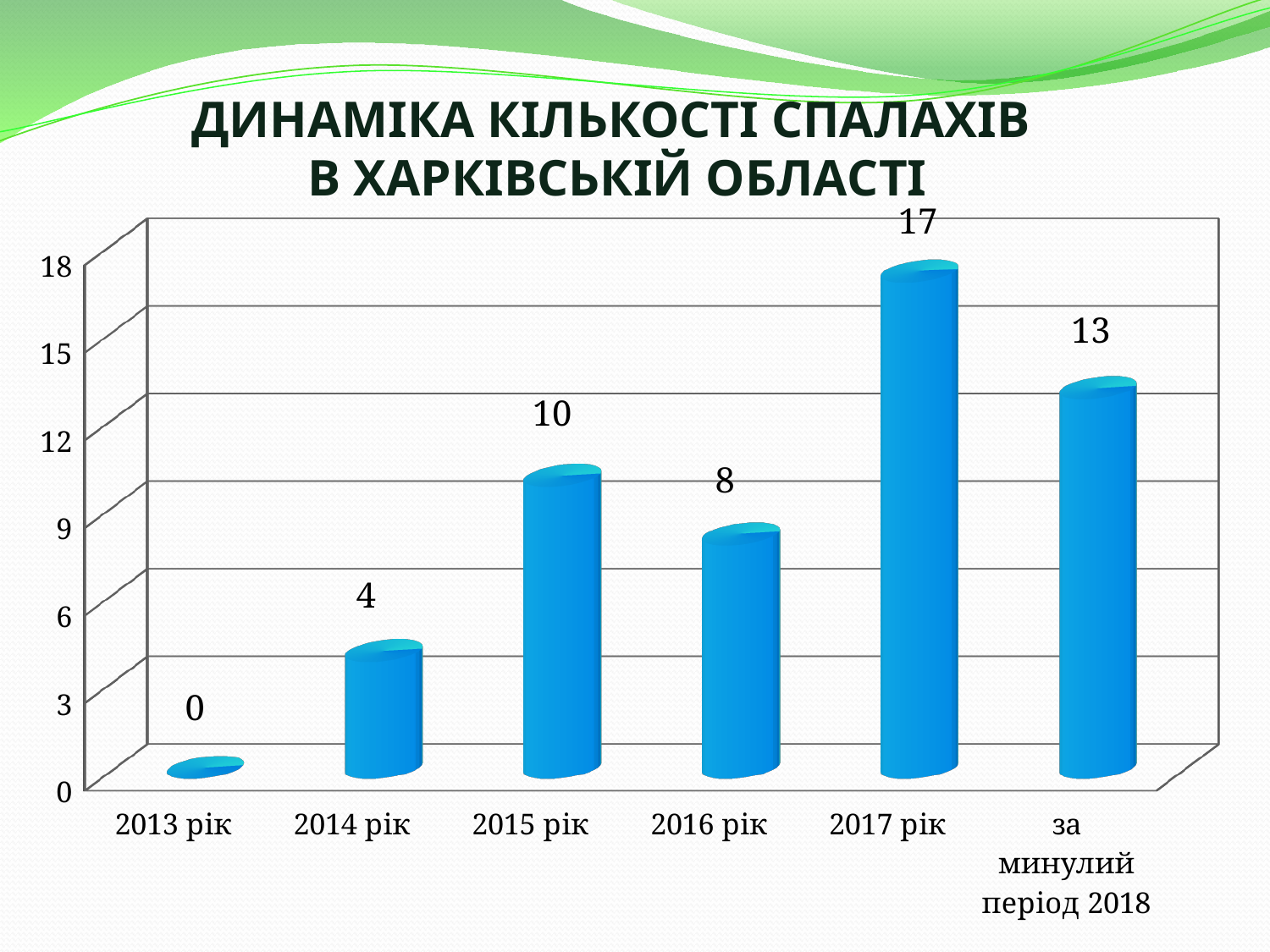
What is the value for 2015 рік? 10 What kind of chart is shown on the slide? bar chart What is the title of the chart? ДИНАМІКА КІЛЬКОСТІ СПАЛАХІВ В ХАРКІВСЬКІЙ ОБЛАСТІ How many categories are shown on the x axis? 6 Which is larger, the value for 2014 рік or the value for 2016 рік? 2016 рік Which category has the highest value? 2017 рік What is the value for за минулий період 2018? 13 Do the values rise or fall from 2013 рік to 2017 рік? rise Which category has the lowest value? 2013 рік What is the value for 2013 рік? 0 What is the value for 2017 рік? 17 What is the difference between the values for 2017 рік and 2016 рік? 9